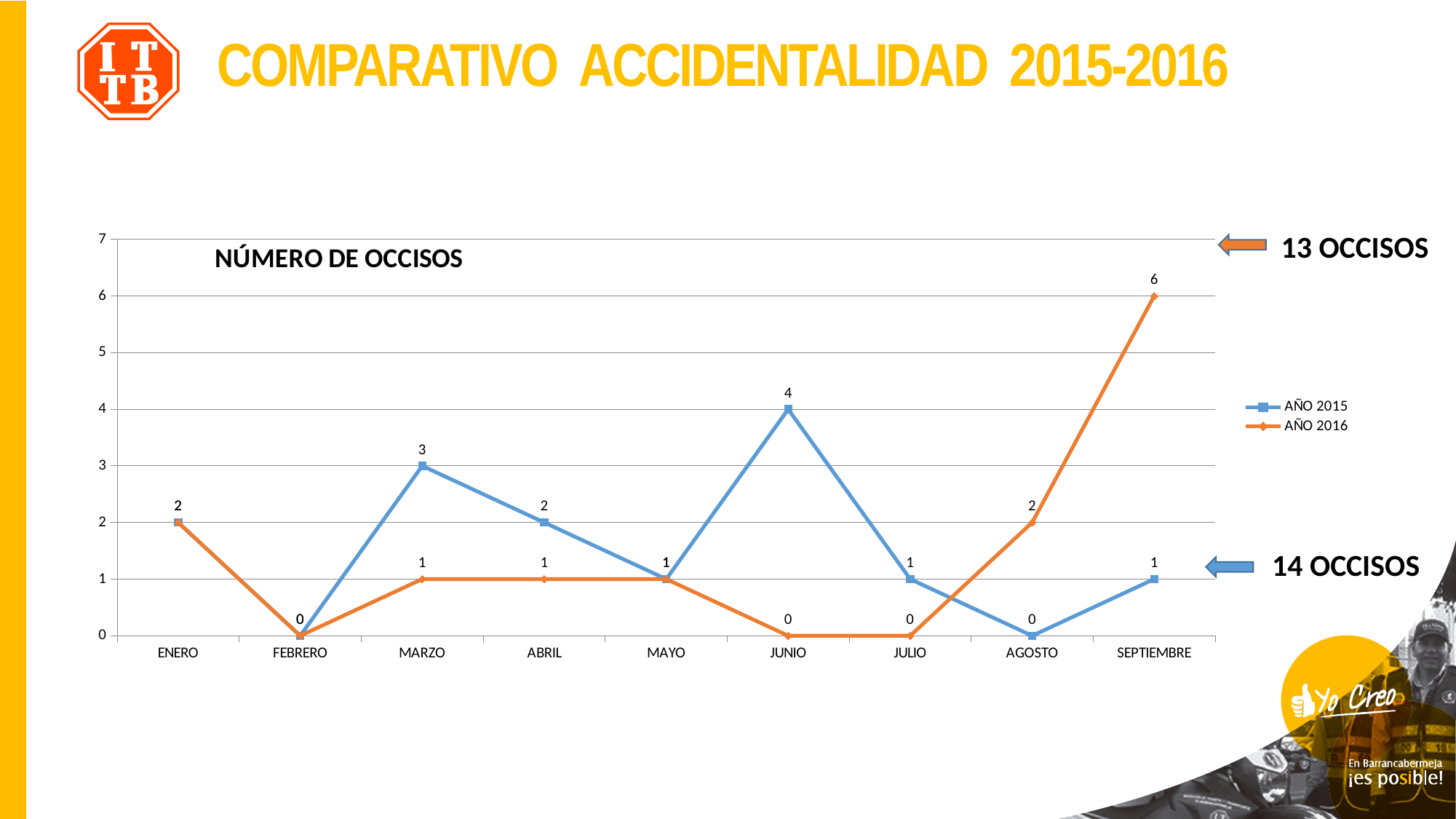
What kind of chart is shown on the slide? Line chart How many months are shown on the x axis? 9 What is the difference between AÑO 2016 and AÑO 2015 in SEPTIEMBRE? 5 Which series has the larger value in AGOSTO, AÑO 2015 or AÑO 2016? AÑO 2016 How many series does the legend list? 2 What is the value for AÑO 2015 in MARZO? 3 What is the title of the chart? NÚMERO DE OCCISOS Does the AÑO 2016 line rise or fall from AGOSTO to SEPTIEMBRE? Rise In which month does AÑO 2015 reach its highest value? JUNIO What is the value for AÑO 2015 in JUNIO? 4 In which month does AÑO 2016 reach its highest value? SEPTIEMBRE What is the value for AÑO 2016 in SEPTIEMBRE? 6